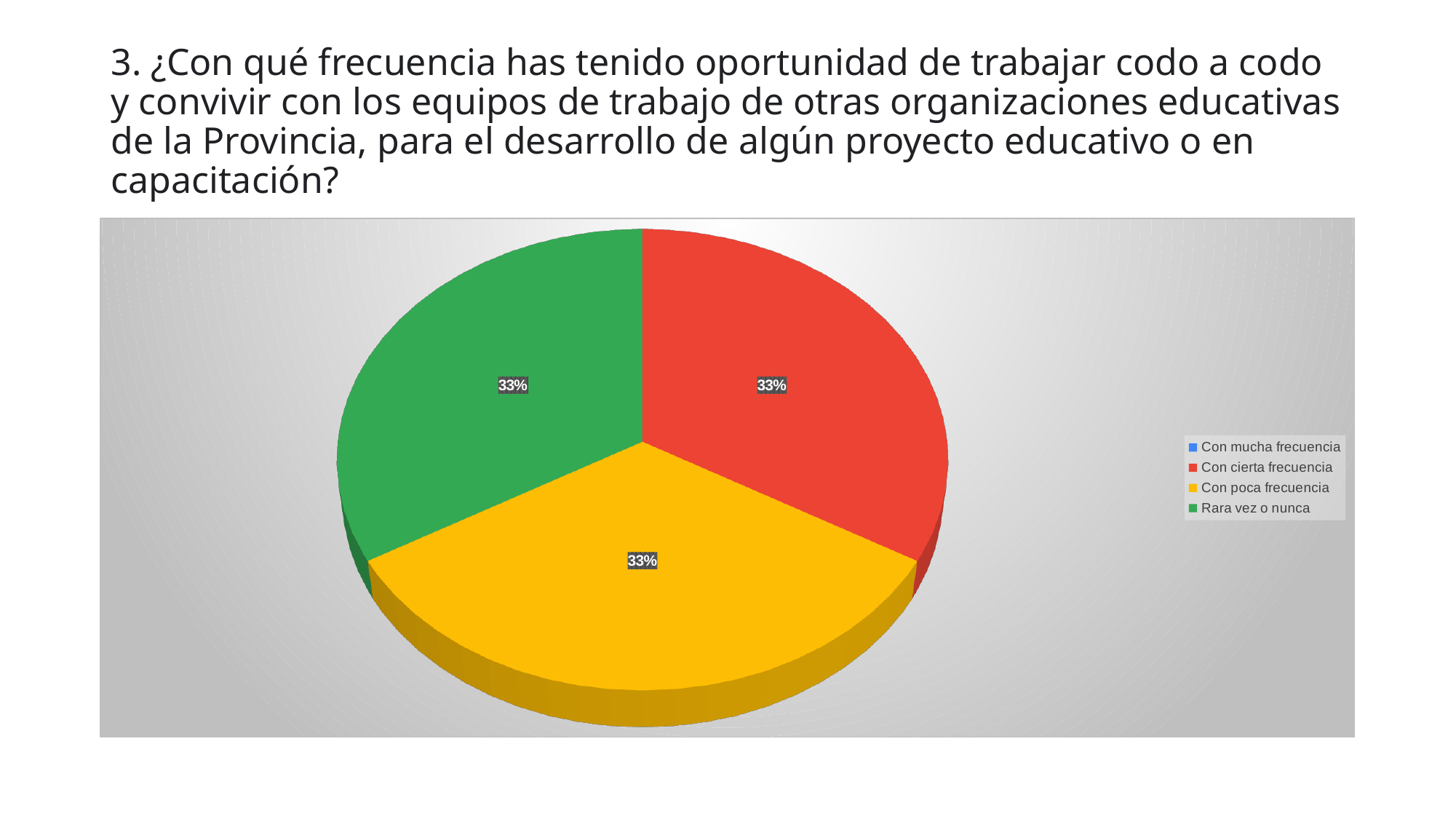
What share of the pie does "Con cierta frecuencia" represent? 33% What is the data label shown on the green slice? 33% Which legend entry has no visible slice in the pie? Con mucha frecuencia How many entries does the legend list? 4 What share of the pie does "Rara vez o nunca" represent? 33% What is the data label shown on the red slice? 33% Which colour represents "Con poca frecuencia" in the legend? yellow Is the share for "Con poca frecuencia" greater or less than 25%? greater What kind of chart is shown on the slide? pie chart Is the share for "Rara vez o nunca" greater or less than 50%? less How many slices with data labels are visible in the pie? 3 What share of the pie does "Con poca frecuencia" represent? 33%